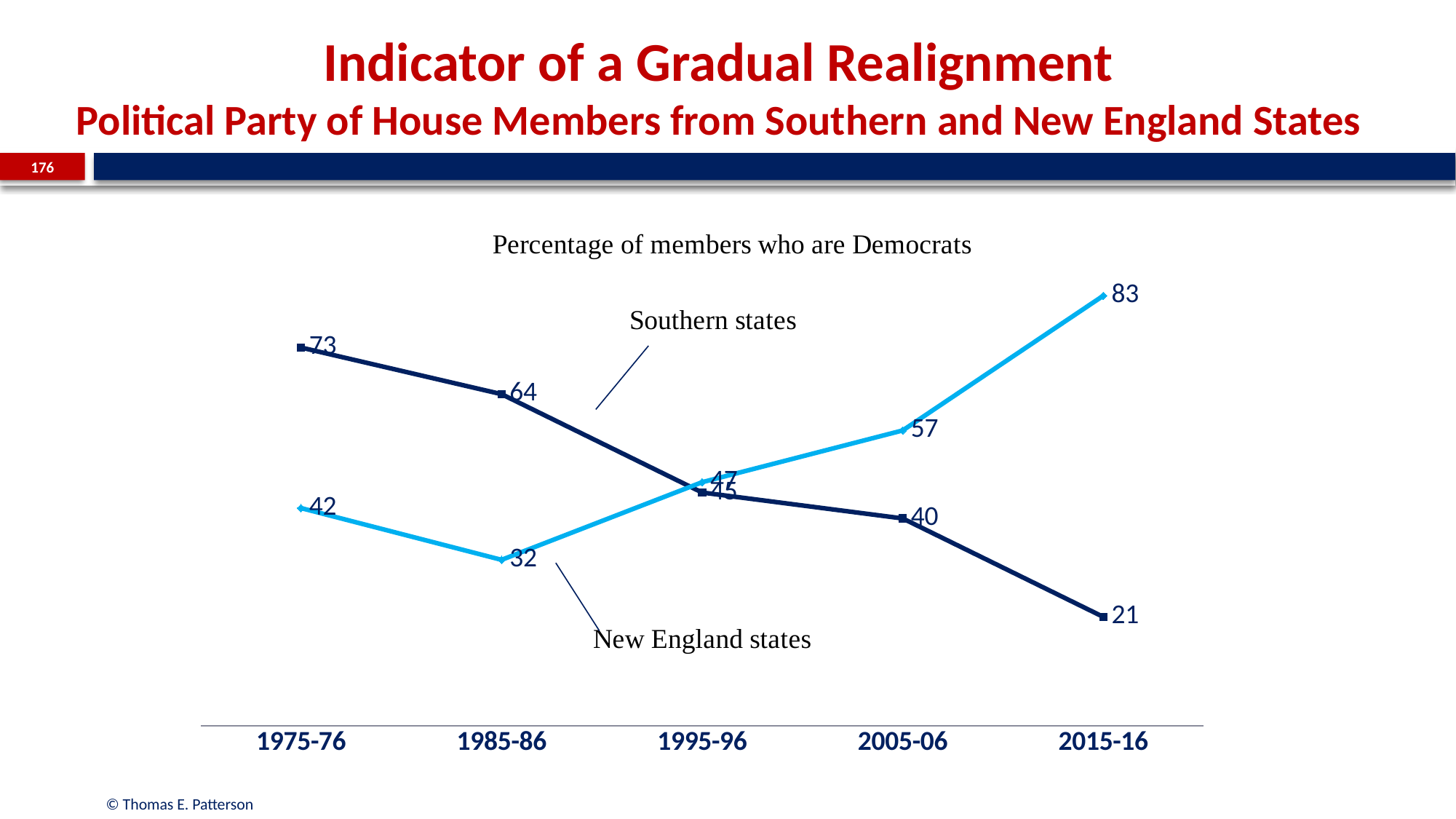
What is the difference between the Southern states value in 1975-76 and in 2015-16? 52 What is the value for New England states in 1985-86? 32 In which period is the New England states value highest? 2015-16 What is the value for Southern states in 2005-06? 40 What type of chart is shown on the slide? line chart How many time periods are shown on the x axis? 5 Does the Southern states line rise or fall from 1975-76 to 2015-16? fall Which is larger in 2005-06, the Southern states value or the New England states value? New England states What is the value for Southern states in 1975-76? 73 In which period is the Southern states value lowest? 2015-16 What is the value for New England states in 2015-16? 83 How many series are plotted on the chart? 2